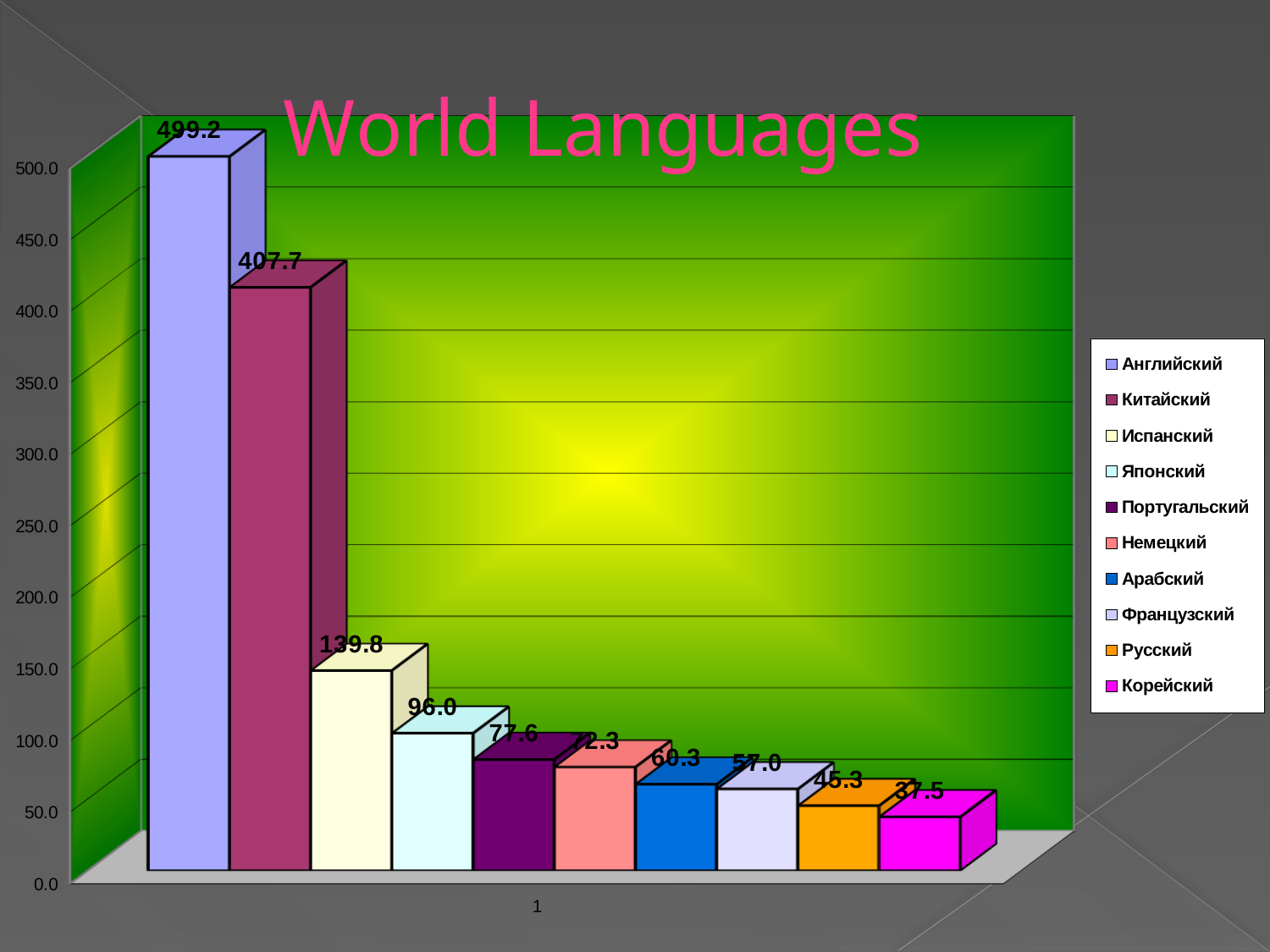
What is the value for Английский? 499.2 Which language has the highest value? Английский Which is larger, the value for Испанский or the value for Японский? Испанский Is the value for Португальский greater or less than 100.0? less How many series does the legend list? 10 What is the difference between the values for Английский and Китайский? 91.5 What is the value for Японский? 96.0 Which language has the lowest value? Корейский What kind of chart is shown on the slide? bar chart What is the value for Арабский? 60.3 What is the value for Китайский? 407.7 What is the value for Испанский? 139.8